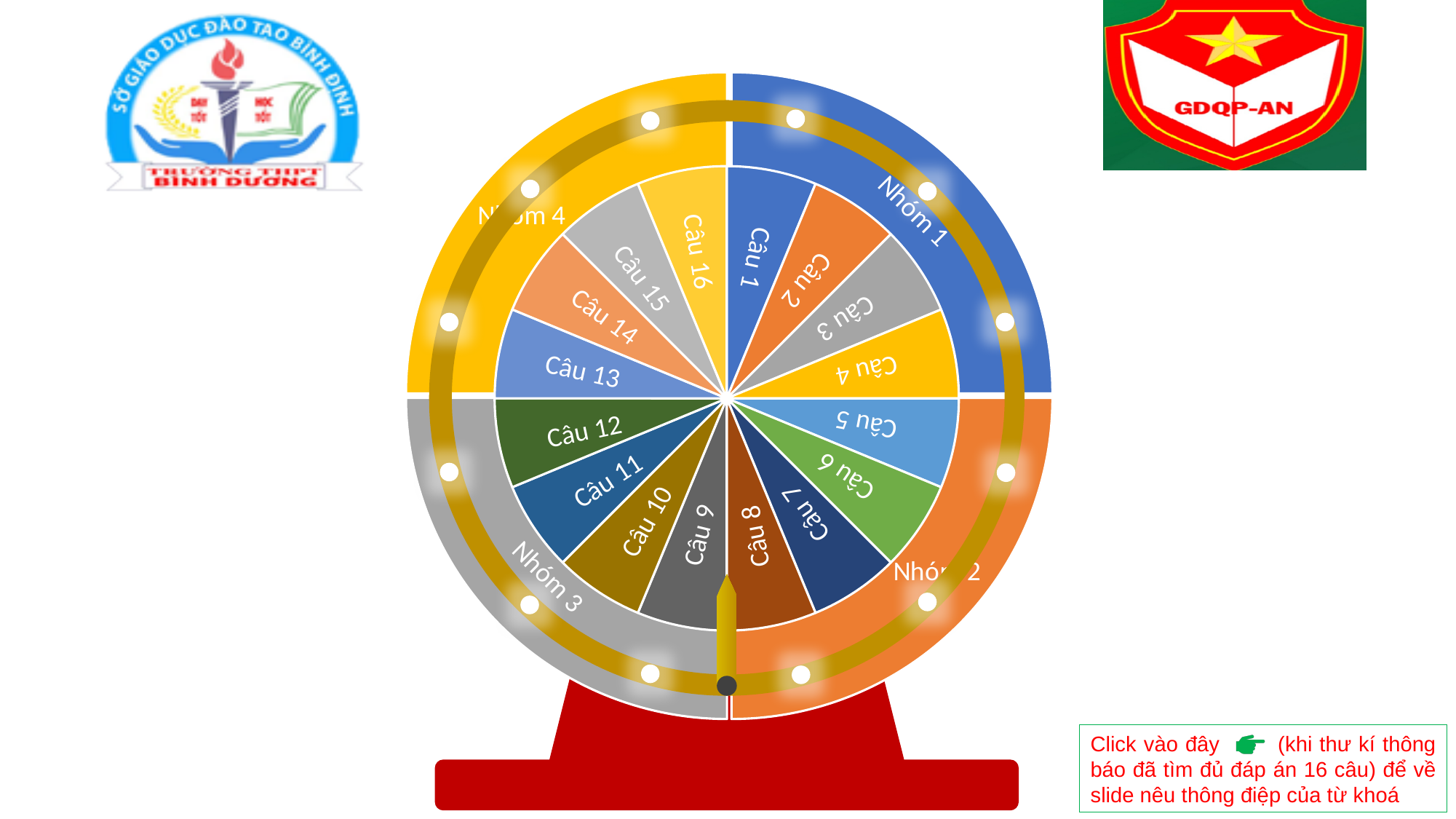
What colour is the outer ring section labelled 'Nhóm 4'? yellow How many slices does the inner pie chart on the wheel have? 16 What is the label of the slice of the inner pie chart just to the left of the top? Câu 16 Which 'Nhóm' label appears on the blue section of the outer ring at the top right? Nhóm 1 How many 'Nhóm' sections does the outer ring of the wheel have? 4 What kind of chart is used for the inner wheel with the 'Câu' labels? pie chart What is the label of the first slice of the inner pie chart, just to the right of the top? Câu 1